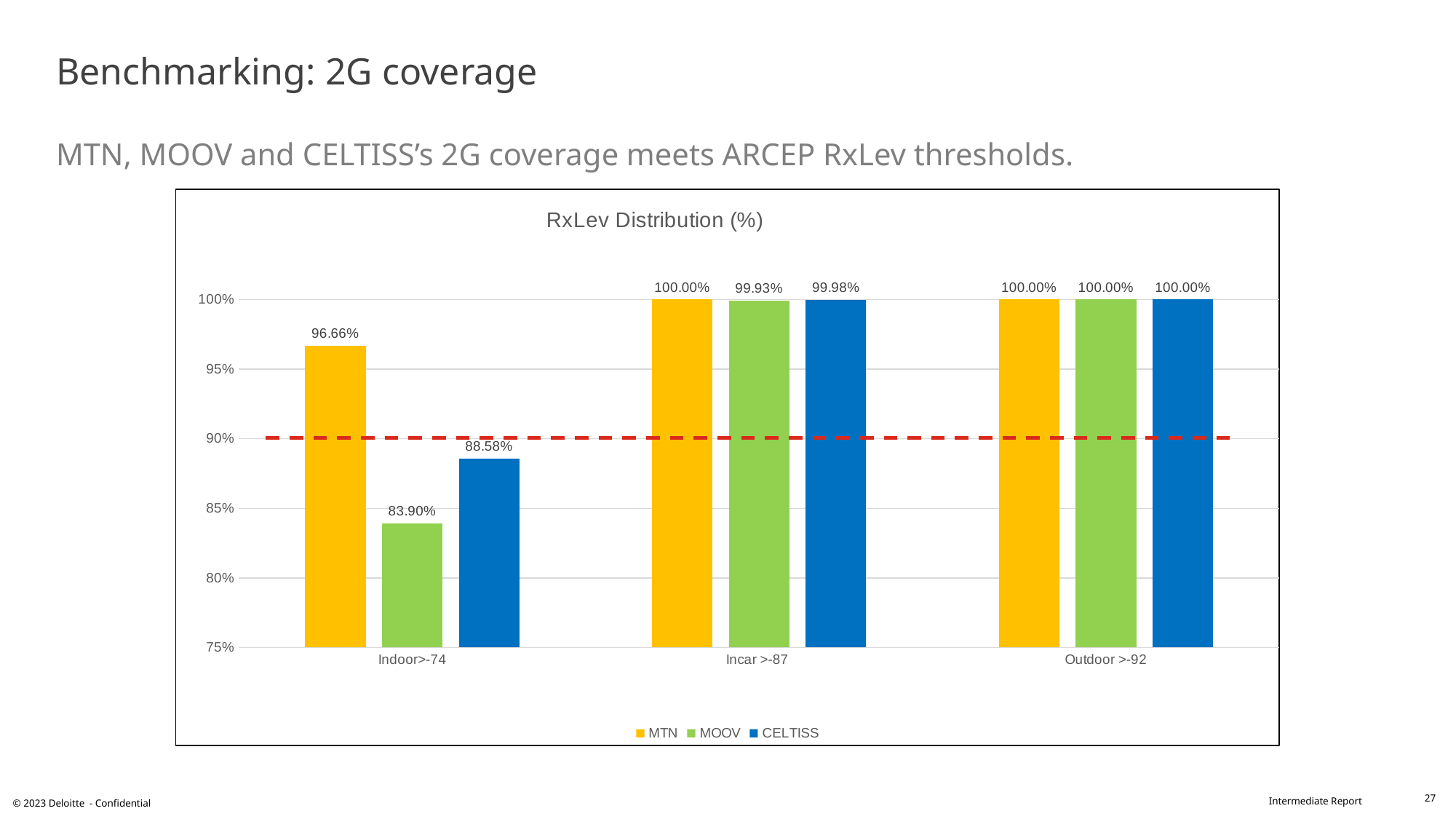
What is the value for MOOV in the Indoor>-74 category? 83.90% What is the title of the chart? RxLev Distribution (%) Which operator has the lowest value in the Indoor>-74 category? MOOV Is the value for CELTISS in the Indoor>-74 category greater or less than 90%? less Which operator has the highest value in the Indoor>-74 category? MTN How many series does the legend list? 3 What is the value for CELTISS in the Incar >-87 category? 99.98% How many categories are shown on the x axis? 3 What is the value for MTN in the Indoor>-74 category? 96.66% What is the difference between MTN and MOOV in the Indoor>-74 category? 12.76% What is the value for MOOV in the Incar >-87 category? 99.93% Which is larger in the Indoor>-74 category: CELTISS or MOOV? CELTISS